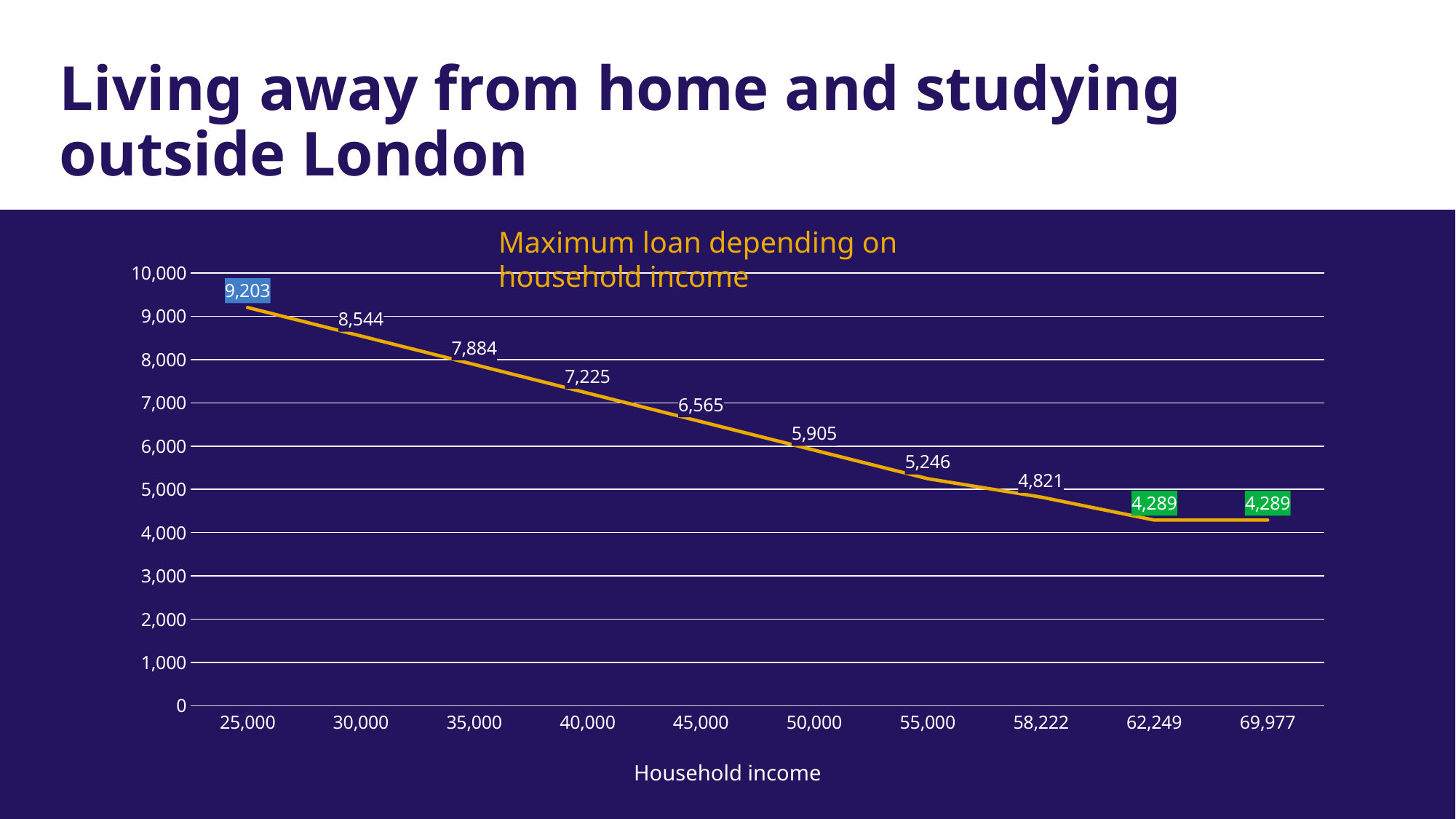
Does the maximum loan rise or fall as household income increases along the x axis? Fall What is the lowest maximum loan value shown on the chart? 4,289 What is the maximum loan for a household income of 25,000? 9,203 What is the maximum loan for a household income of 69,977? 4,289 Which is larger, the maximum loan at 35,000 or at 40,000 household income? 35,000 What is the maximum loan for a household income of 58,222? 4,821 What is the maximum loan for a household income of 45,000? 6,565 At which household income is the maximum loan highest? 25,000 What is the difference between the maximum loan at 50,000 and at 55,000 household income? 659 How many household income points are plotted on the chart? 10 What kind of chart is shown on the slide? Line chart What is the difference between the maximum loan at 25,000 and at 30,000 household income? 659